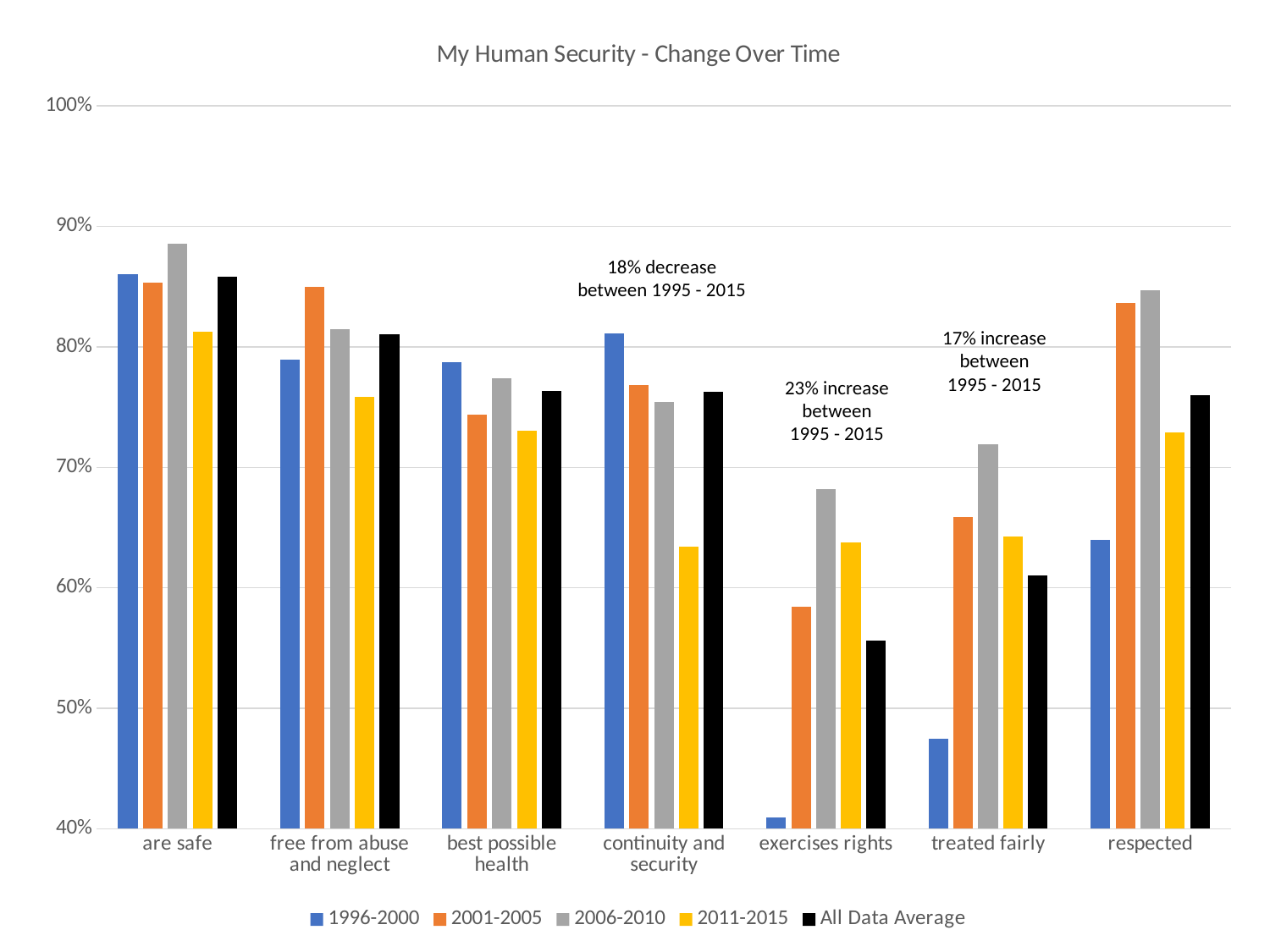
What is the title of the chart? My Human Security - Change Over Time Which category has the lowest 1996-2000 value? exercises rights For 'continuity and security', which is larger: the 1996-2000 value or the 2011-2015 value? 1996-2000 What kind of chart is shown on the slide? bar chart Is the 2006-2010 value for 'are safe' greater or less than 80%? greater Is the 2011-2015 value for 'continuity and security' greater or less than 70%? less How many series does the legend list? 5 For 'treated fairly', which is larger: the 1996-2000 value or the 2006-2010 value? 2006-2010 Is the 1996-2000 value for 'exercises rights' greater or less than 50%? less Which category has the highest 2006-2010 value? are safe How many categories are shown along the x axis? 7 What does the annotation above the 'continuity and security' bars say? 18% decrease between 1995 - 2015